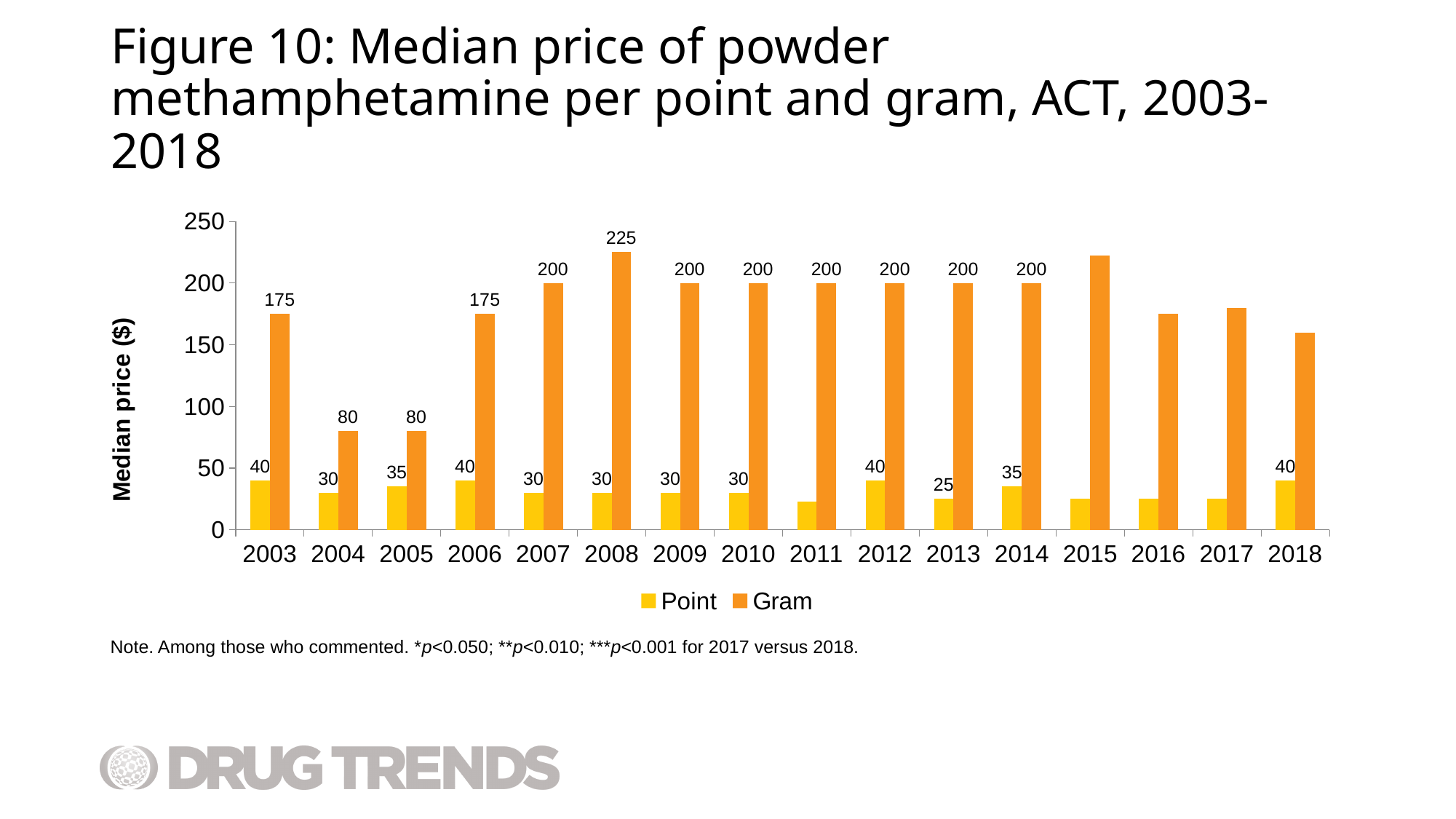
What is the median price per point in 2013? 25 Which is larger, the median price per gram in 2006 or in 2007? 2007 What is the median price per gram in 2004? 80 What kind of chart is shown on the slide? Bar chart Is the median price per point in 2011 greater or less than 50? less How many series does the legend list? 2 Which year has the highest median price per gram? 2008 How many years are shown on the x axis? 16 What is the median price per gram in 2008? 225 Is the median price per gram in 2015 greater or less than 200? greater Is the median price per gram in 2018 greater or less than 150? greater What is the difference between the gram price and the point price in 2003? 135